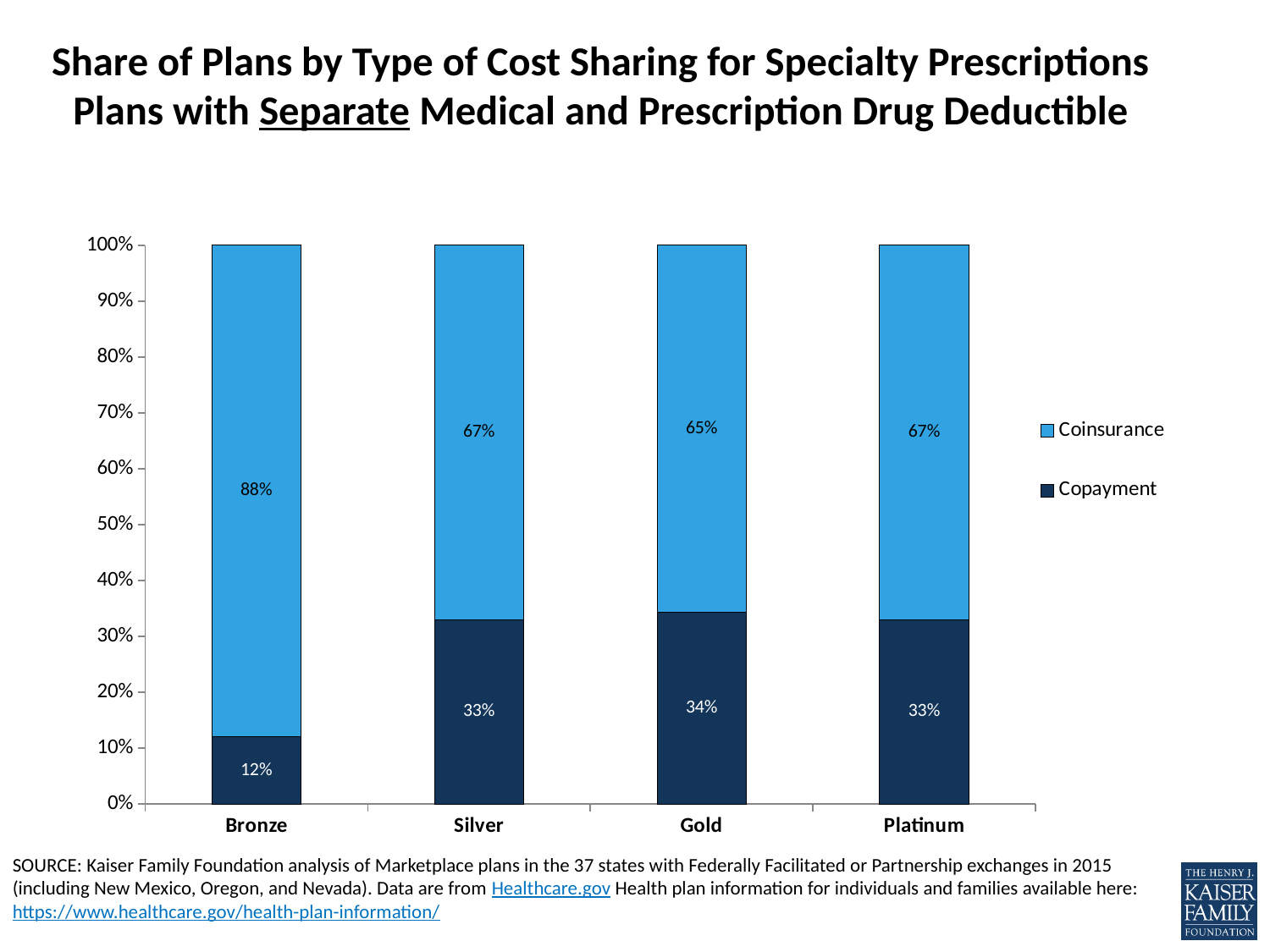
Which plan type has the highest Coinsurance share? Bronze What is the Coinsurance share for Platinum plans? 67% What is the difference between the Coinsurance share for Bronze and for Gold? 23% How many series does the legend list? 2 Which legend entry is shown in the darker blue colour? Copayment What is the Copayment share for Silver plans? 33% Which plan type has the lowest Copayment share? Bronze What is the Copayment share for Gold plans? 34% How many plan types are shown on the x axis? 4 Is the Copayment share larger for Bronze or for Gold? Gold What is the Coinsurance share for Bronze plans? 88% What kind of chart is shown on the slide? Stacked bar chart